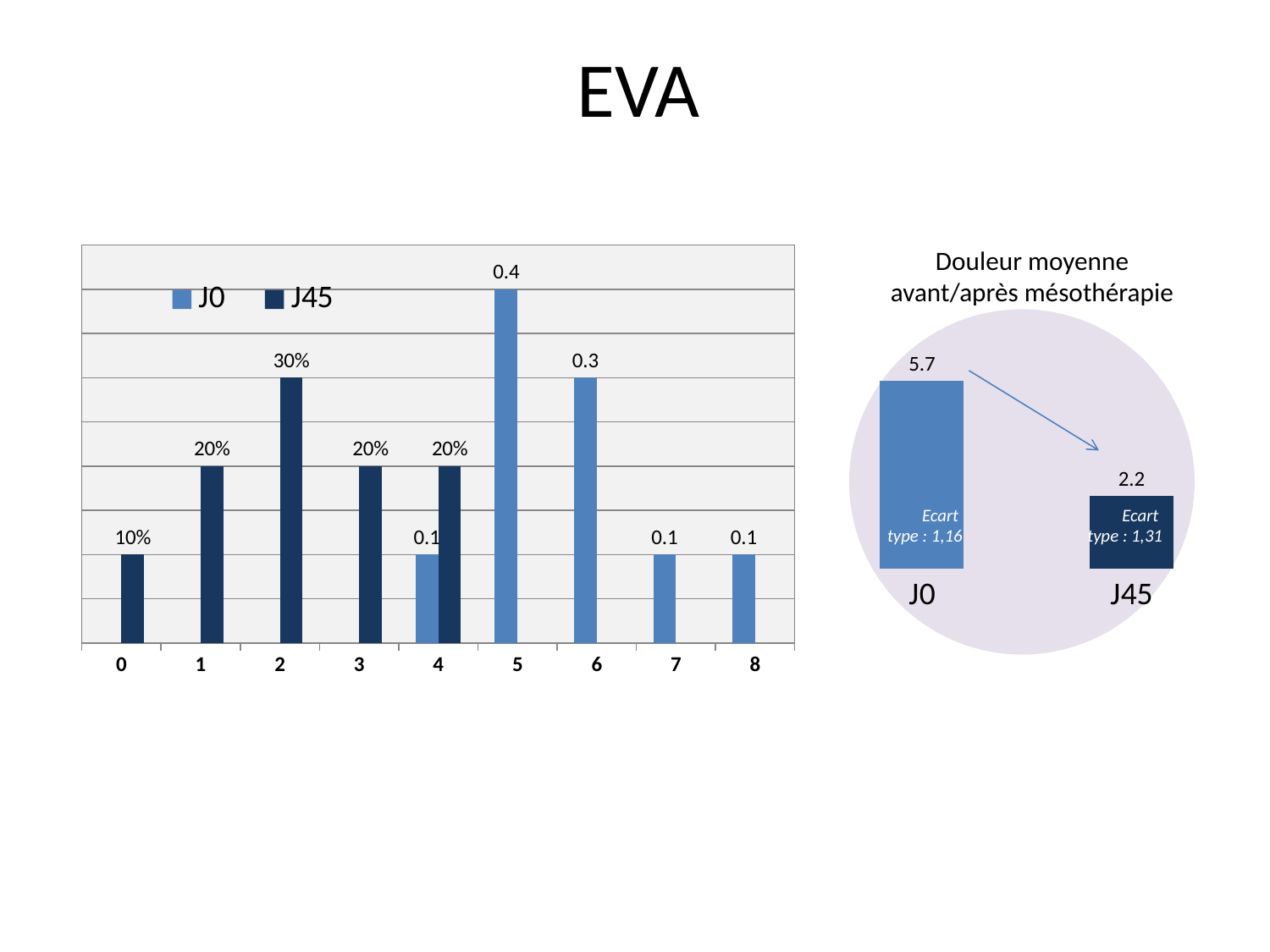
In the chart on the left, for category 4, which series has the taller bar, J0 or J45? J45 In the chart on the left, what is the J45 value for category 0? 10% What kind of chart is the chart on the left of the slide? bar chart In the chart on the left, what is the J0 value for category 5? 0.4 In the chart on the right titled 'Douleur moyenne avant/après mésothérapie', what is the difference between the J0 and J45 values? 3.5 In the chart on the left, how many series does the legend list? 2 In the chart on the left, what is the J0 value for category 6? 0.3 In the chart on the right titled 'Douleur moyenne avant/après mésothérapie', what is the value for J0? 5.7 In the chart on the left, what is the J45 value for category 2? 30% In the chart on the left, how many categories are shown on the x axis? 9 In the chart on the left, which category has the highest J0 value? 5 In the chart on the left, which category has the highest J45 value? 2